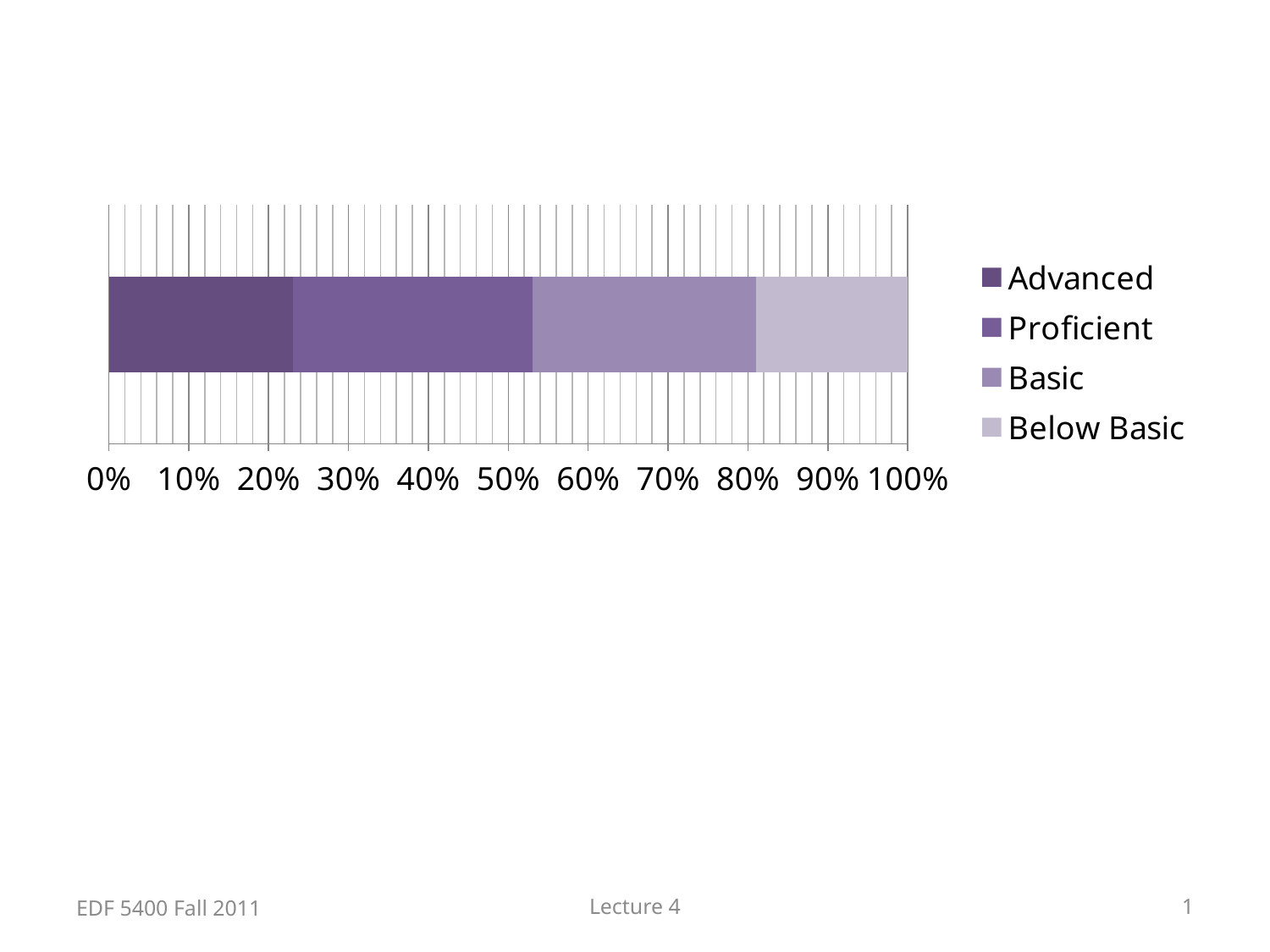
Is the share of the bar taken by the Basic segment greater or less than 40%? less Is the share of the bar taken by the Below Basic segment greater or less than 30%? less What kind of chart is shown on the slide? Stacked bar chart Is the share of the bar taken by the Proficient segment greater or less than 20%? greater Which segment is larger, Advanced or Proficient? Proficient How many bars are plotted in the chart? 1 What is the highest value shown on the horizontal axis? 100% What are the series names listed in the legend? Advanced, Proficient, Basic, Below Basic Which series is shown in the darkest purple colour? Advanced How many series does the legend list? 4 Which segment is larger, Proficient or Below Basic? Proficient